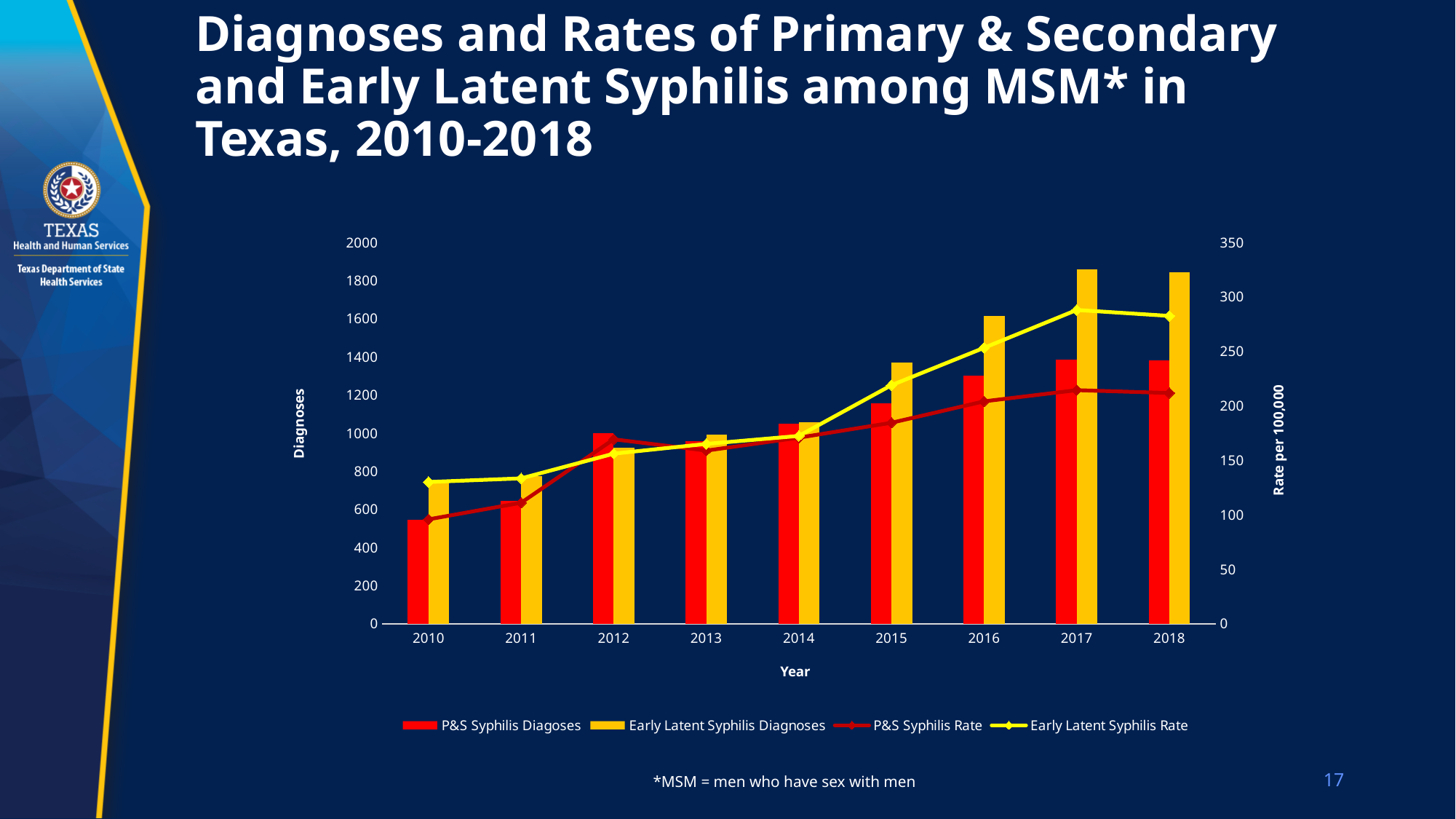
How many years are shown along the x axis? 9 Is the P&S Syphilis Rate in 2010 greater or less than 150? less In 2015, which is larger: P&S Syphilis Diagnoses or Early Latent Syphilis Diagnoses? Early Latent Syphilis Diagnoses Does the Early Latent Syphilis Rate rise or fall from 2010 to 2017? rise Is the Early Latent Syphilis Rate in 2017 greater or less than 250? greater Is the value for P&S Syphilis Diagnoses in 2010 greater or less than 600? less How many series does the legend list? 4 What is the label of the right-hand vertical axis? Rate per 100,000 In which year were P&S Syphilis Diagnoses lowest? 2010 What kind of chart is shown on the slide? A combined bar and line chart